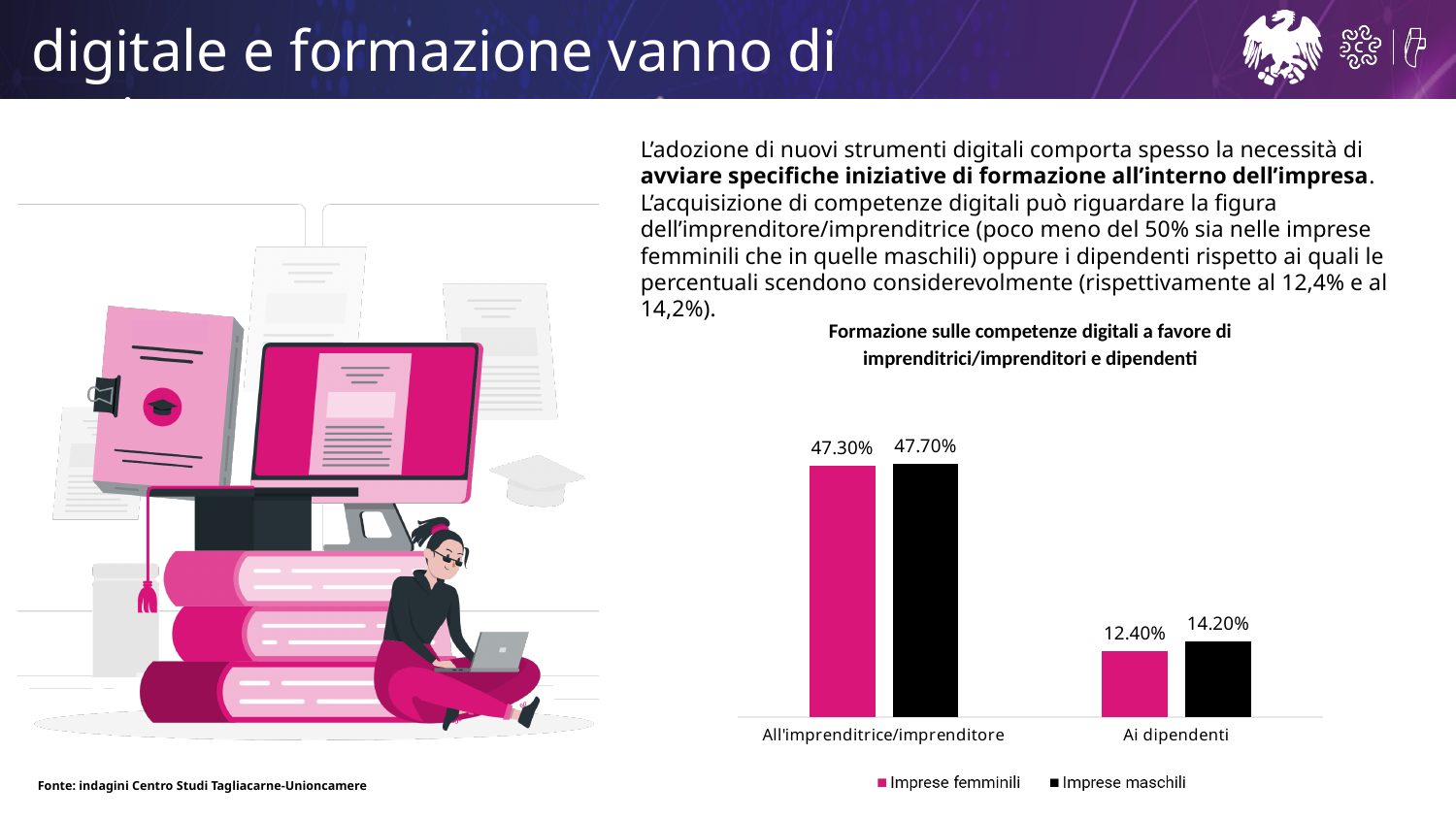
What is the value for Imprese maschili in the All'imprenditrice/imprenditore category? 47.70% How many categories are shown on the x axis? 2 Which category has the highest value for Imprese maschili? All'imprenditrice/imprenditore What is the difference between the Imprese maschili and Imprese femminili values in the Ai dipendenti category? 1.80% What kind of chart is shown on the slide? Bar chart What is the value for Imprese femminili in the All'imprenditrice/imprenditore category? 47.30% What is the value for Imprese femminili in the Ai dipendenti category? 12.40% Which category has the lowest value for Imprese femminili? Ai dipendenti Which is larger in the Ai dipendenti category: Imprese femminili or Imprese maschili? Imprese maschili How many series does the legend list? 2 Which colour represents Imprese femminili in the chart? Pink What is the value for Imprese maschili in the Ai dipendenti category? 14.20%